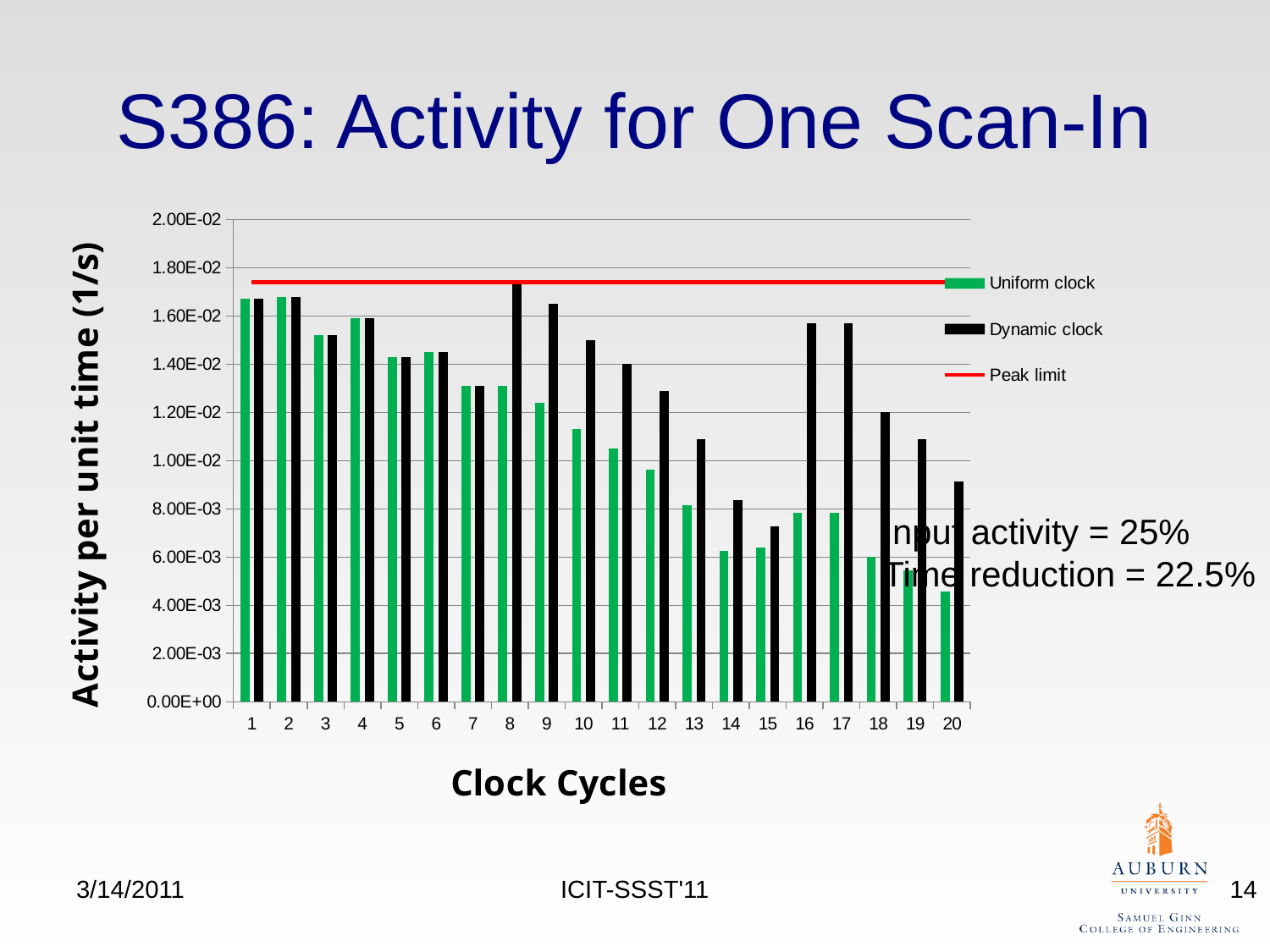
Is the Uniform clock value at clock cycle 20 greater or less than 6.00E-03? less At clock cycle 8, which series has the larger value, Uniform clock or Dynamic clock? Dynamic clock Is the Dynamic clock value at clock cycle 16 greater or less than 1.40E-02? greater What kind of chart is shown on the slide? bar chart How many series does the legend list? 3 Do the Uniform clock values generally rise or fall as the clock cycles increase? fall Is the Dynamic clock value at clock cycle 8 greater or less than 1.60E-02? greater What is the title of the x axis? Clock Cycles How many clock cycles are shown on the x axis? 20 For the Uniform clock series, which is larger, the value at clock cycle 1 or at clock cycle 20? clock cycle 1